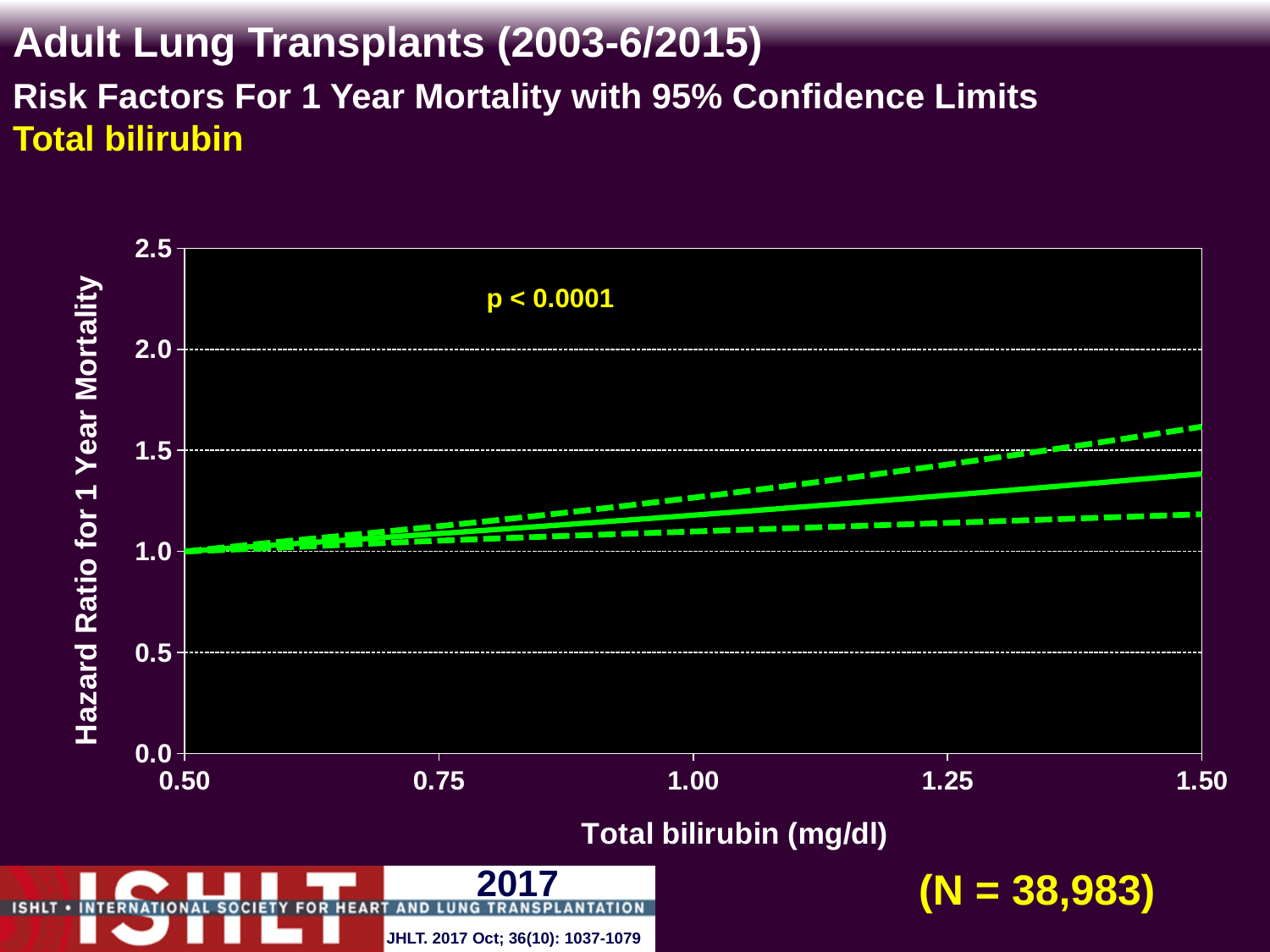
Is the hazard ratio shown by the solid line at a total bilirubin of 1.50 mg/dl greater or less than 1.0? greater Is the hazard ratio shown by the solid line at a total bilirubin of 1.00 mg/dl greater or less than 1.5? less Is the upper confidence limit (upper dashed line) at a total bilirubin of 1.50 mg/dl greater or less than 1.5? greater What is the label of the x axis of the chart? Total bilirubin (mg/dl) What p-value is printed on the chart? p < 0.0001 How many lines are plotted on the chart? 3 Which is larger at a total bilirubin of 1.50 mg/dl: the upper dashed line or the lower dashed line? the upper dashed line What kind of chart is shown on the slide? line chart Does the hazard ratio for 1 year mortality rise or fall as total bilirubin increases from 0.50 to 1.50 mg/dl? rise